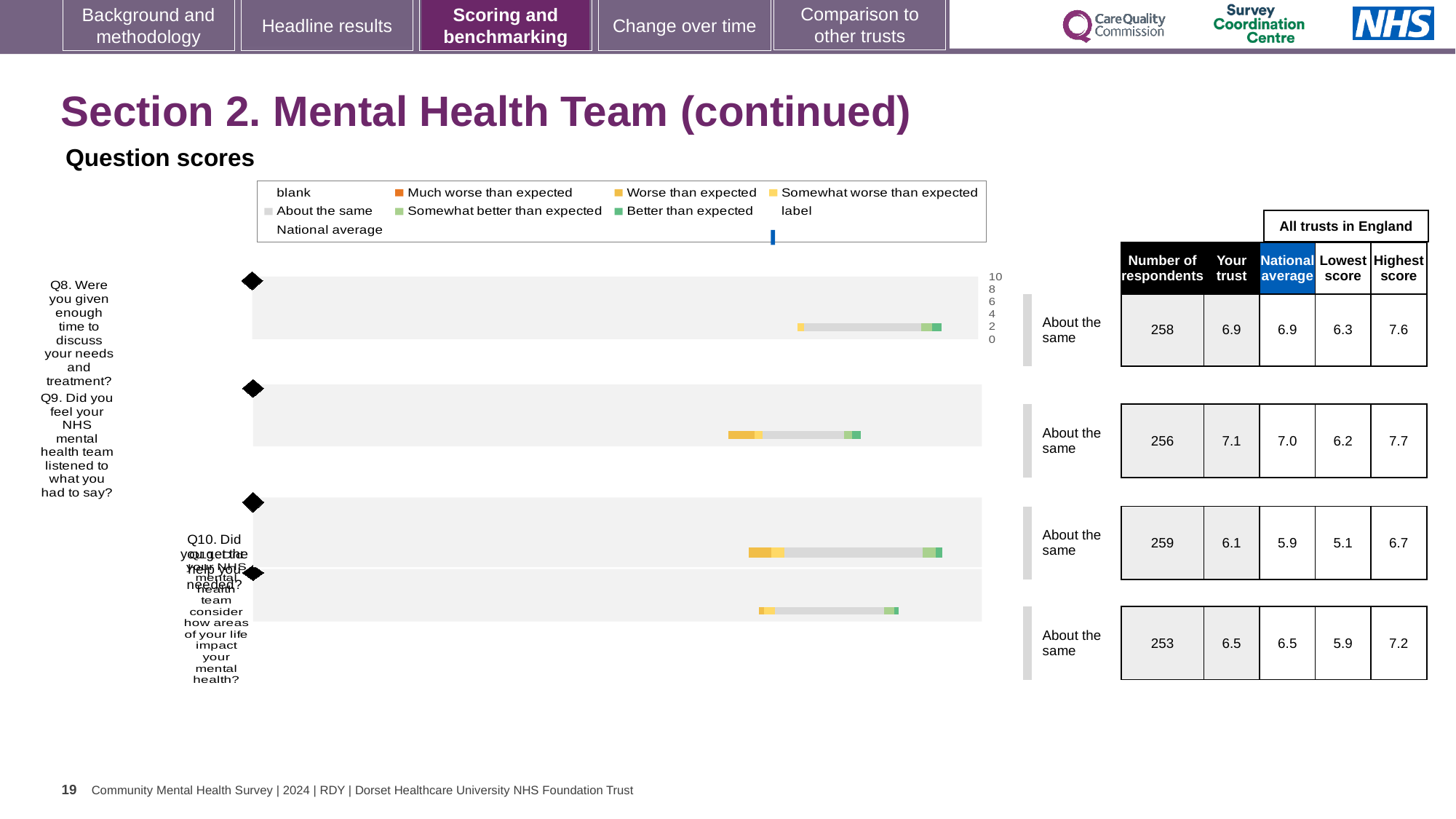
What is the highest score across all trusts in England for Q11? 7.2 What is the 'Your trust' score for Q8 (Were you given enough time to discuss your needs and treatment?)? 6.9 What is the number of respondents for Q9 (Did you feel your NHS mental health team listened to what you had to say?)? 256 What is the difference between the highest score and the lowest score for Q8? 1.3 Which question has the highest 'Your trust' score? Q9 In the chart legend, which colour represents 'Better than expected'? green What is the national average score for Q10 (Did you get the help you needed?)? 5.9 What kind of chart is used to show the question scores on this slide? bar chart Which question has the lowest 'Your trust' score? Q10 How many questions (bars) are plotted in the question scores chart? 4 For Q10, which is larger: the 'Your trust' score or the national average? Your trust In the chart legend, which colour represents 'Much worse than expected'? orange